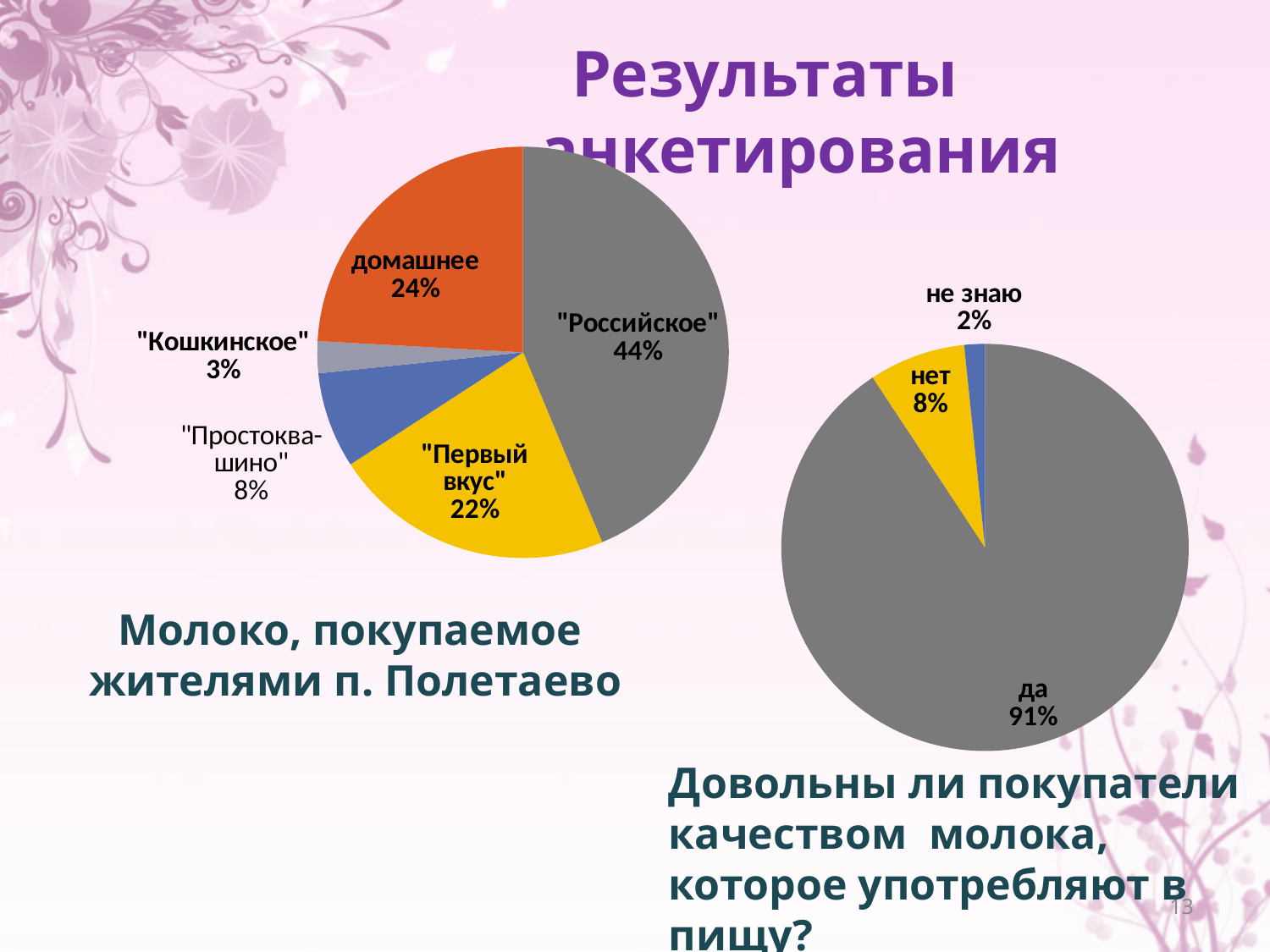
In the left pie chart, what share is labelled for "Первый вкус"? 22% What type of chart is used on the right side of the slide? pie chart In the left pie chart (Молоко, покупаемое жителями п. Полетаево), what share is labelled for "Российское"? 44% In the left pie chart, how many slices does the pie have? 5 In the right pie chart, how many slices does the pie have? 3 In the left pie chart, which category has the smallest slice? "Кошкинское" In the left pie chart, which is larger: the share for домашнее or the share for "Простоквашино"? домашнее In the right pie chart, what share is labelled for не знаю? 2% In the right pie chart (Довольны ли покупатели качеством молока), what share is labelled for да? 91% In the left pie chart, what is the difference between the shares for "Российское" and "Первый вкус"? 22% In the left pie chart, which category has the largest slice? "Российское" In the left pie chart, what share is labelled for домашнее? 24%